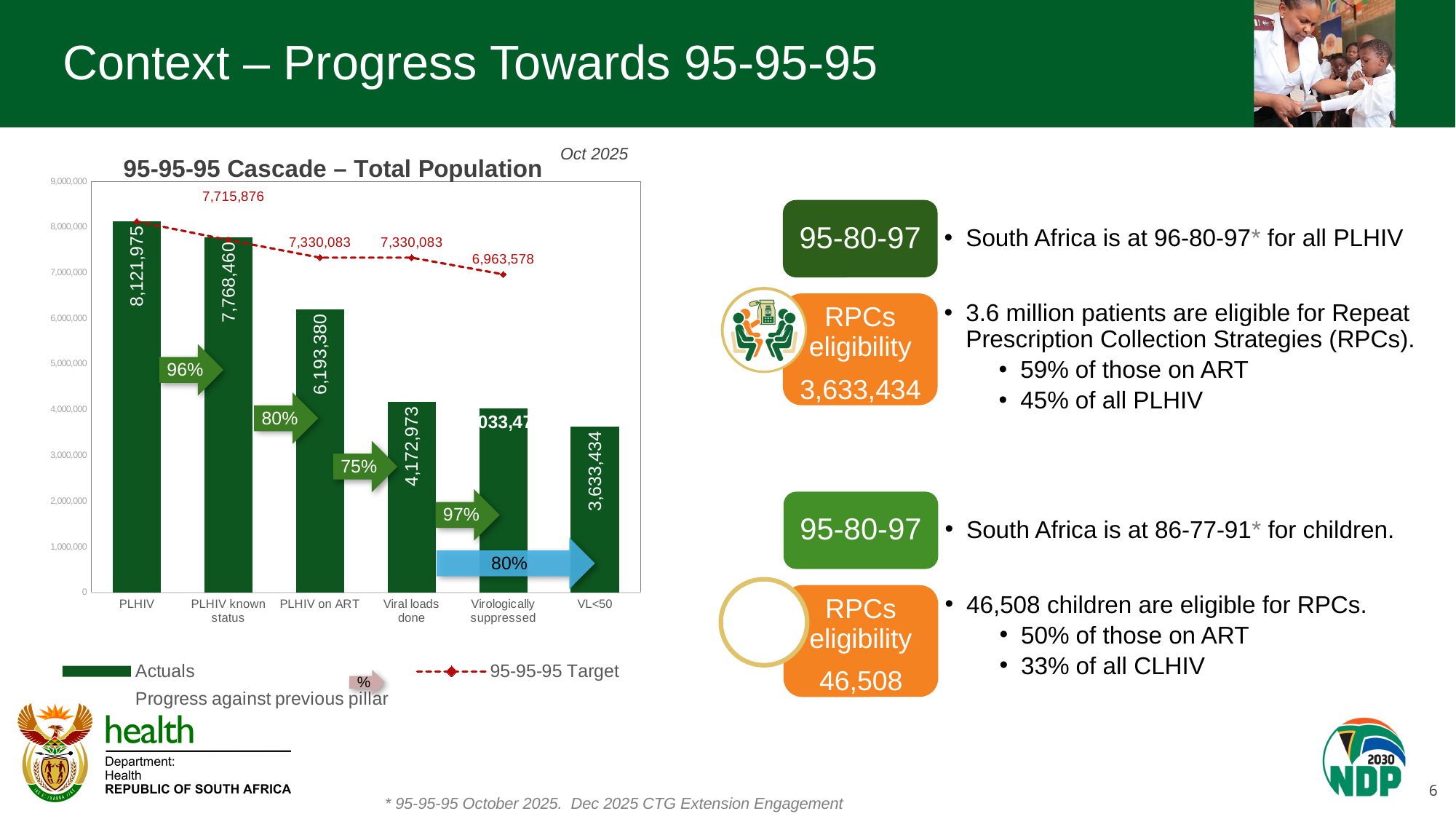
What is the Actuals value for PLHIV on ART? 6,193,380 What is the Actuals value for PLHIV in the 95-95-95 Cascade chart? 8,121,975 Is the Actuals value for Virologically suppressed greater or less than 5,000,000? less What is the Actuals value for VL<50? 3,633,434 What is the 95-95-95 Target value shown at PLHIV known status? 7,715,876 What kind of chart is the 95-95-95 Cascade – Total Population chart? combination bar and line chart Which category has the lowest Actuals bar? VL<50 How many categories are shown on the x axis of the cascade chart? 6 Which is larger, the Actuals bar for PLHIV on ART or for Viral loads done? PLHIV on ART Do the Actuals bars rise or fall from left to right across the cascade? fall Which category has the highest Actuals bar? PLHIV What is the difference between the Actuals for PLHIV known status and PLHIV on ART? 1,575,080